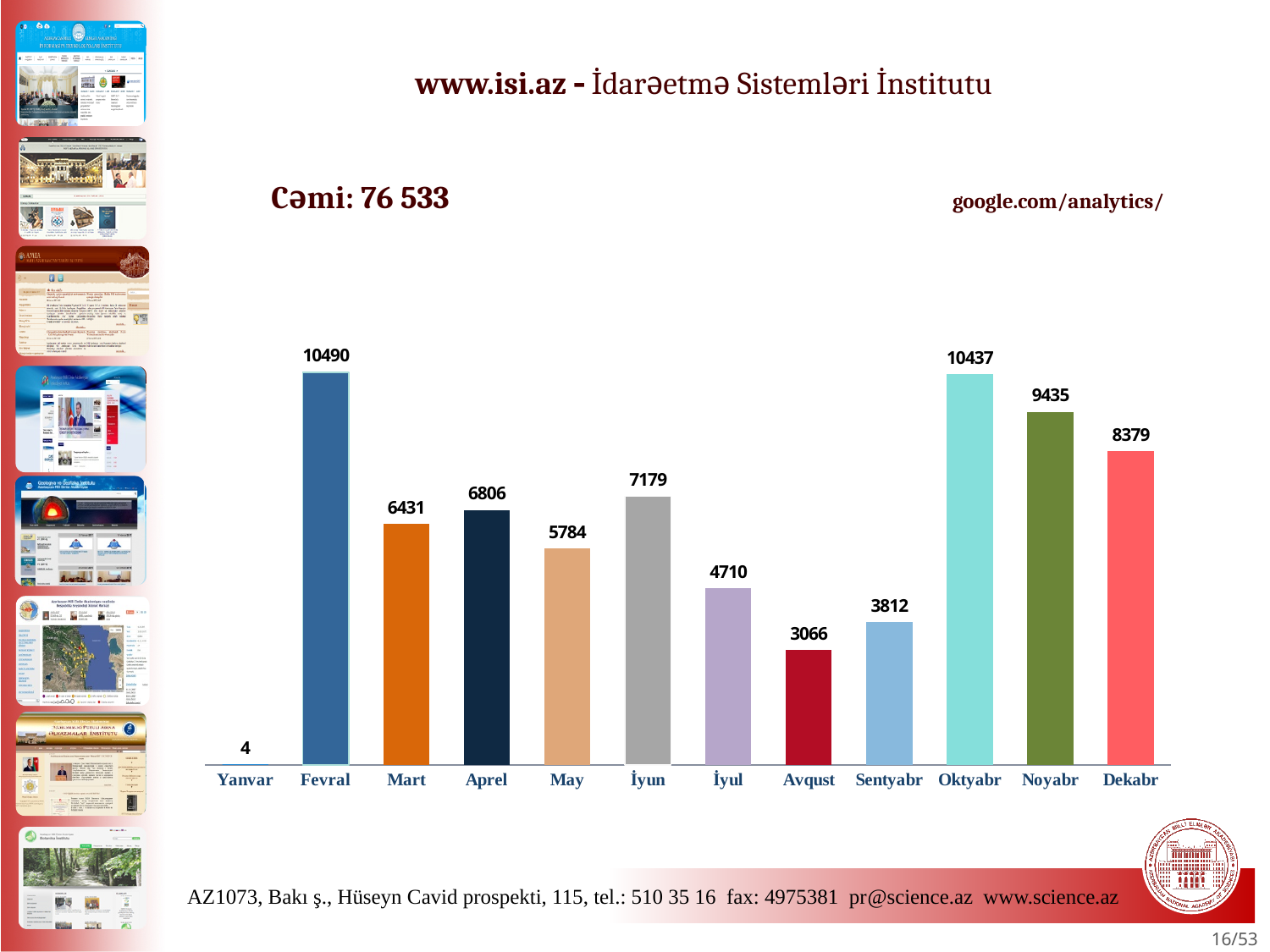
How many months are shown on the x axis? 12 Do the values rise or fall from Avqust to Oktyabr? Rise What is the value for Oktyabr? 10437 What is the value for Yanvar? 4 What is the value for Avqust? 3066 Which month has the highest value? Fevral What is the value for Fevral? 10490 Which is larger, the value for Mart or the value for Aprel? Aprel What kind of chart is shown on the slide? Bar chart What total (Cəmi) is stated on the slide? 76 533 Which month has the lowest value? Yanvar What is the difference between the values for Noyabr and Dekabr? 1056